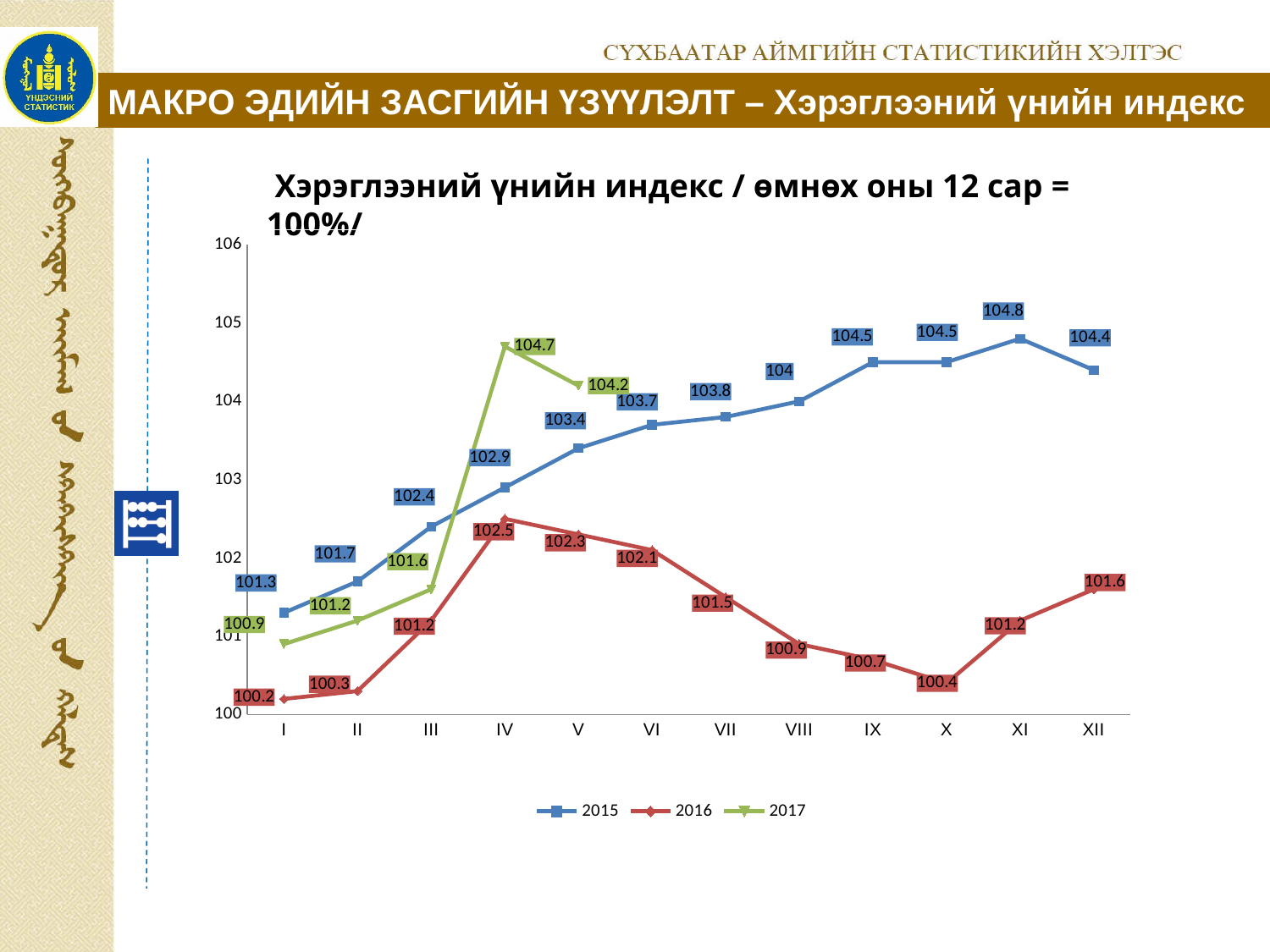
What is the value for 2017 in month V? 104.2 How many months are plotted for the 2017 series? 5 Which series is drawn in green? 2017 In which month does the 2015 series reach its highest value? XI What is the difference between the 2015 and 2016 values in month XII? 2.8 What is the value for 2016 in month IV? 102.5 What type of chart is shown on the slide? line chart In which month does the 2016 series reach its lowest value? I What is the value for 2015 in month XI? 104.8 How many series does the legend list? 3 Which series has the larger value in month IV, 2017 or 2015? 2017 Does the 2016 series rise or fall from month IV to month X? fall